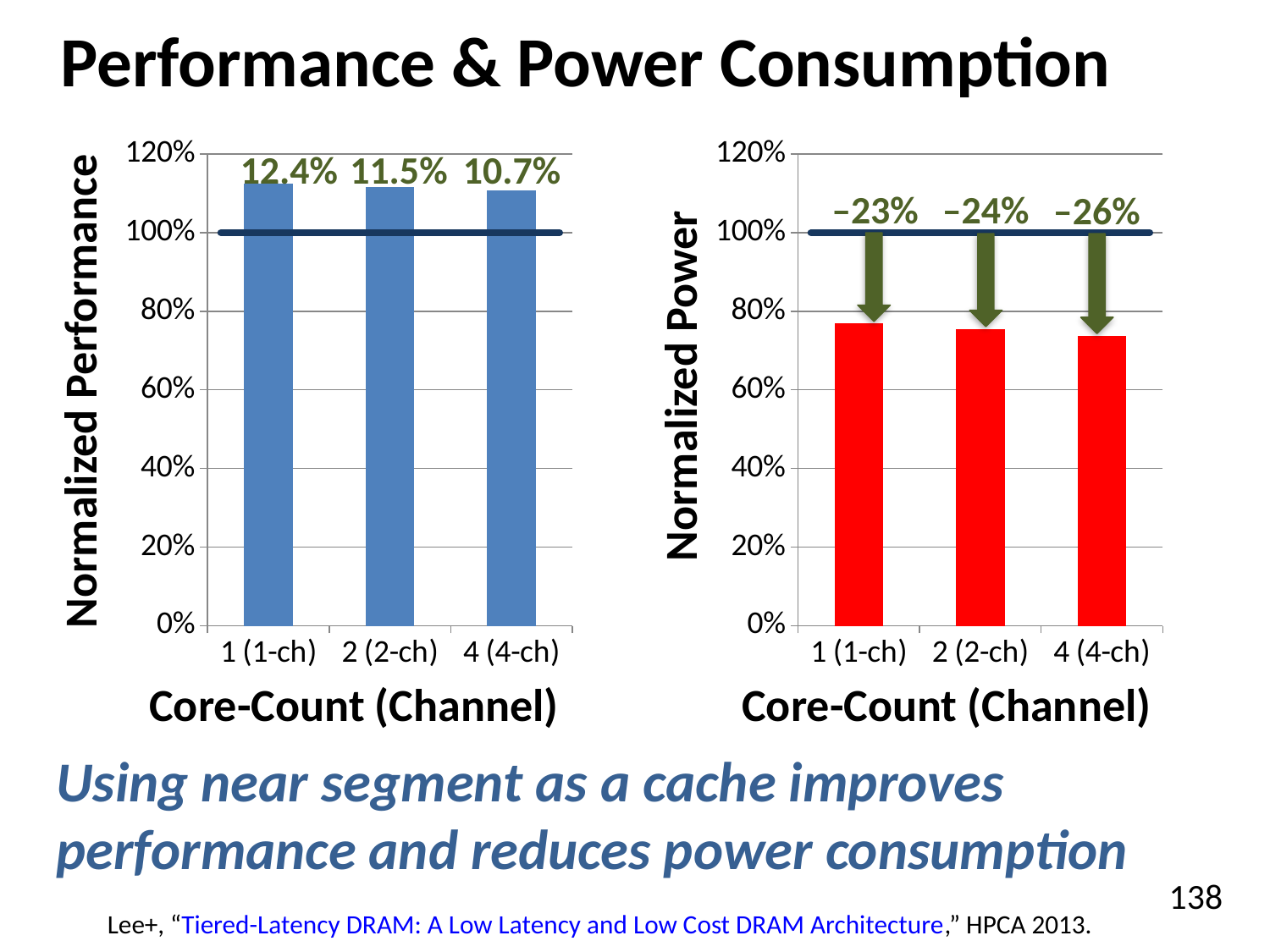
On the Normalized Power chart (right), is the value for 1 (1-ch) greater or less than 80%? less On the Normalized Performance chart (left), which core-count category has the highest bar? 1 (1-ch) How many core-count categories are shown on the Normalized Power chart (right)? 3 What kind of chart is the Normalized Performance chart (left)? bar chart On the Normalized Power chart (right), which core-count category has the lowest bar? 4 (4-ch) On the Normalized Power chart (right), what label is shown above the bar for 4 (4-ch)? –26% On the Normalized Performance chart (left), what label is shown above the bar for 4 (4-ch)? 10.7% On the Normalized Performance chart (left), is the value for 2 (2-ch) greater or less than 100%? greater On the Normalized Power chart (right), what power reduction label is shown above the bar for 2 (2-ch)? –24% On the Normalized Performance chart (left), do the bar values rise or fall as the core count increases from 1 to 4? fall On the Normalized Performance chart (left), what performance improvement label is shown above the bar for 1 (1-ch)? 12.4% What is the x-axis title of the Normalized Power chart (right)? Core-Count (Channel)